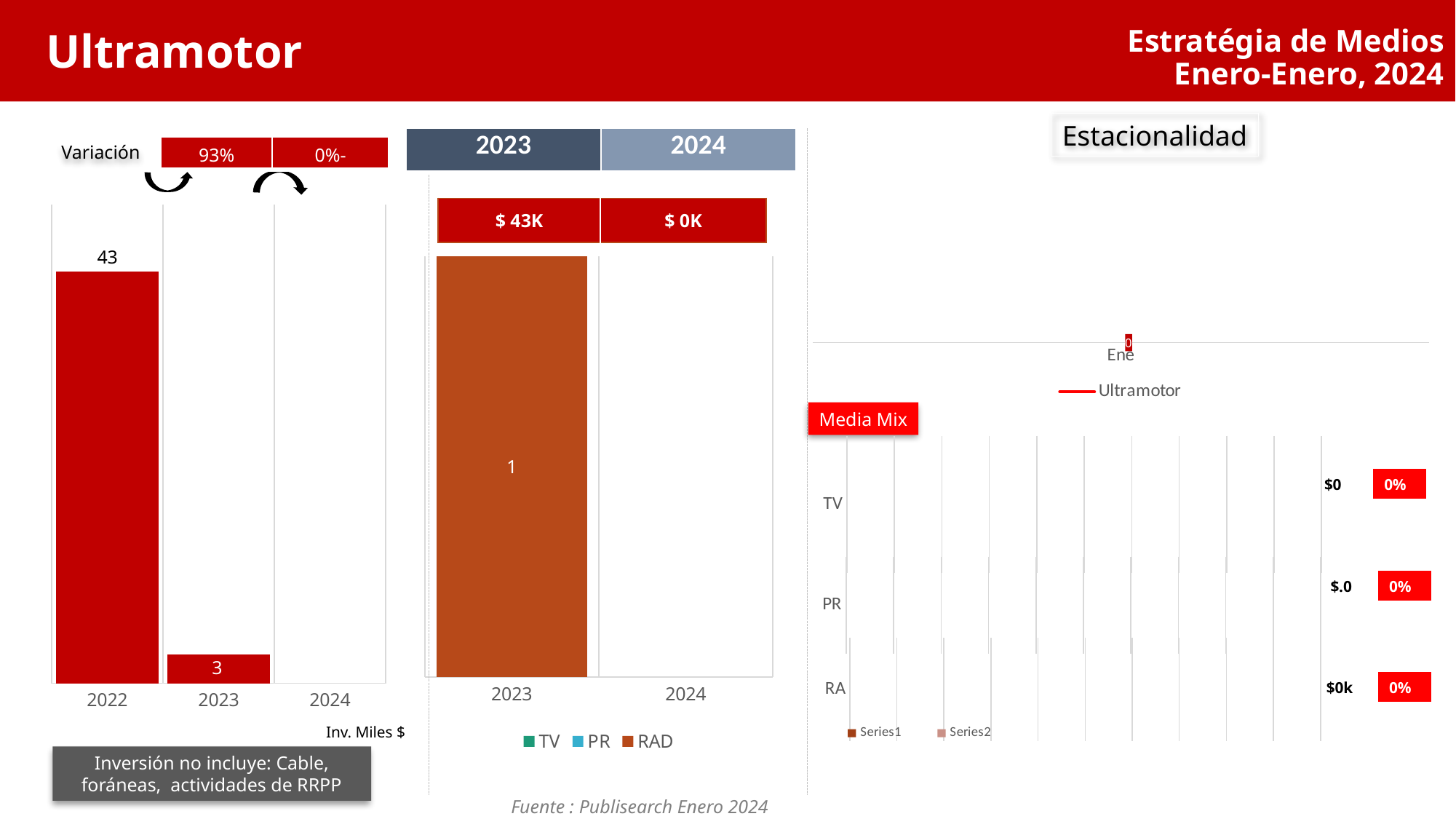
On the left bar chart, how many year categories are shown on the x axis? 3 On the middle stacked bar chart, how many series does the legend list? 3 On the middle stacked bar chart, what total is shown in the box above the 2023 bar? $ 43K On the left bar chart, what is the difference between the 2022 and 2023 values? 40 On the left bar chart, which year has the highest value? 2022 On the left bar chart, what is the value for 2022? 43 On the Media Mix chart, what percentage is shown for TV? 0% What type of chart is the left chart showing 2022, 2023 and 2024? Bar chart On the Estacionalidad line chart, what is the value shown for Ene? 0 On the left bar chart, which is larger, the value for 2022 or the value for 2023? 2022 On the middle stacked bar chart, what is the data label on the RAD segment for 2023? 1 On the left bar chart, what is the value for 2023? 3